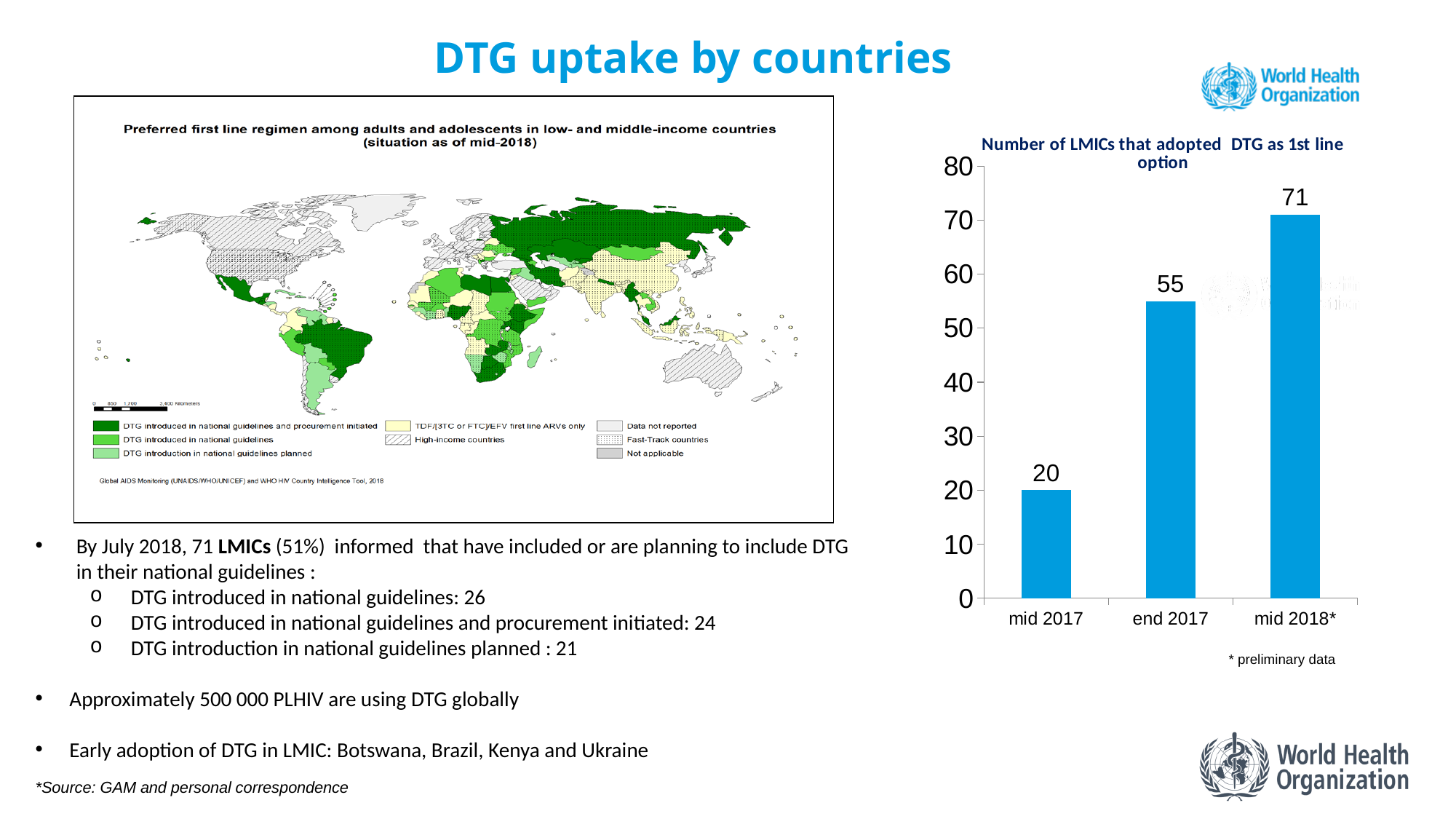
In the bar chart, is the value for end 2017 greater or less than 50? greater In the bar chart, what is the difference between the values for end 2017 and mid 2017? 35 How many bars are shown in the bar chart? 3 In the bar chart, which period has the lowest value? mid 2017 What kind of chart is used to show the number of LMICs that adopted DTG as 1st line option? bar chart In the bar chart, what is the number of LMICs that adopted DTG as 1st line option at mid 2017? 20 In the bar chart, which period has the highest number of LMICs that adopted DTG? mid 2018* In the bar chart, what is the difference between the values for mid 2018* and end 2017? 16 In the bar chart, what is the value for end 2017? 55 In the bar chart, what is the value for mid 2018*? 71 In the bar chart, which is larger, the value for end 2017 or the value for mid 2017? end 2017 In the bar chart, do the values rise or fall from mid 2017 to mid 2018*? rise